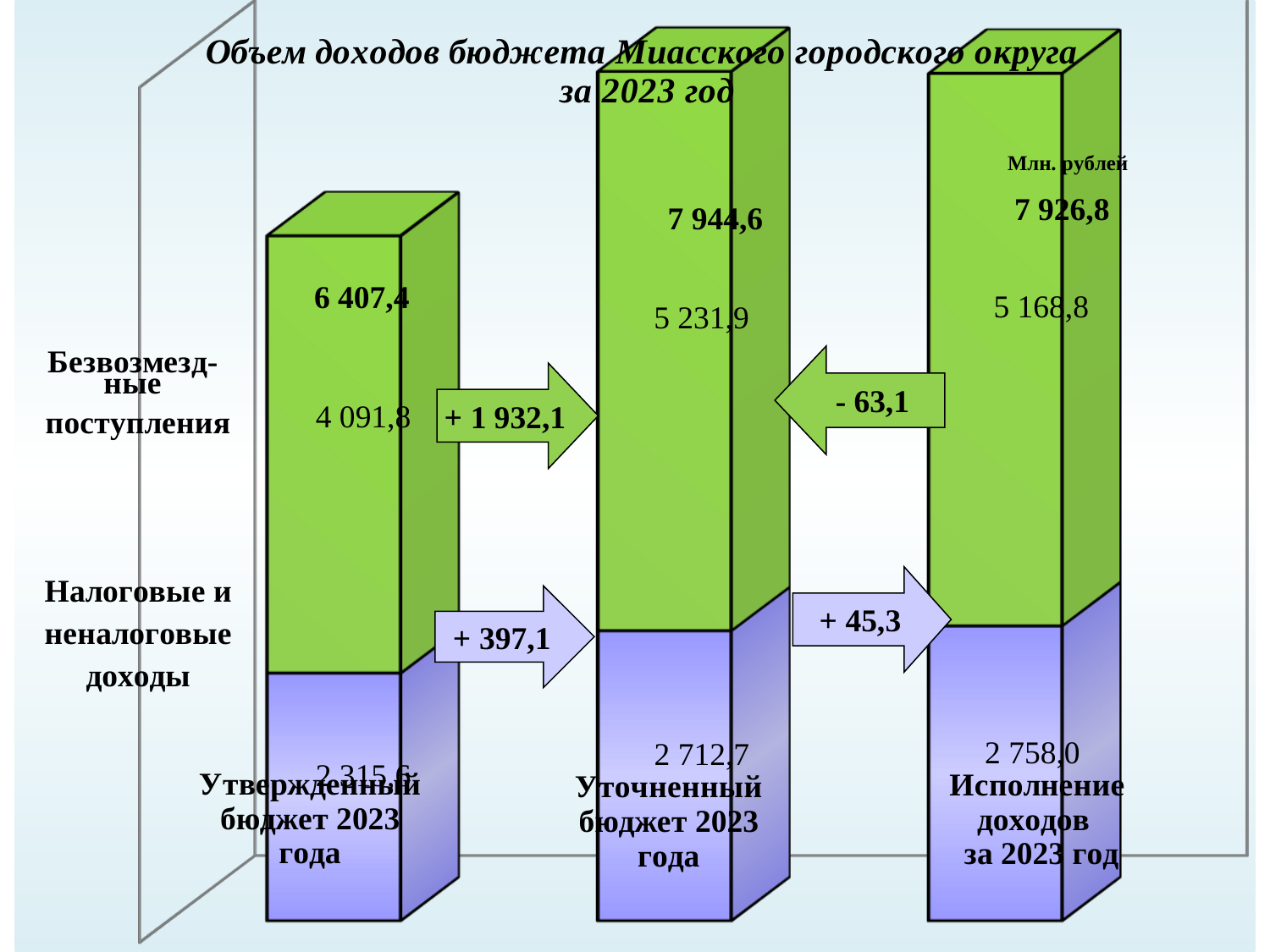
How many bars are shown in the chart? 3 Which bar has the lowest total value? Утвержденный бюджет 2023 года Which bar has the highest total value? Уточненный бюджет 2023 года Which is larger: 'Налоговые и неналоговые доходы' in 'Уточненный бюджет 2023 года' or in 'Исполнение доходов за 2023 год'? Исполнение доходов за 2023 год What is the total value shown for the 'Исполнение доходов за 2023 год' bar? 7 926,8 What is the value of 'Безвозмездные поступления' in the 'Утвержденный бюджет 2023 года' bar? 4 091,8 What is the value of 'Безвозмездные поступления' in the 'Уточненный бюджет 2023 года' bar? 5 231,9 What type of chart is shown on the slide? Stacked bar chart What is the total value shown for the 'Утвержденный бюджет 2023 года' bar? 6 407,4 What is the value of 'Налоговые и неналоговые доходы' in the 'Исполнение доходов за 2023 год' bar? 2 758,0 What is the total value shown for the 'Уточненный бюджет 2023 года' bar? 7 944,6 What is the difference between the 'Безвозмездные поступления' values of the 'Уточненный бюджет 2023 года' and 'Исполнение доходов за 2023 год' bars, as shown by the arrow? - 63,1